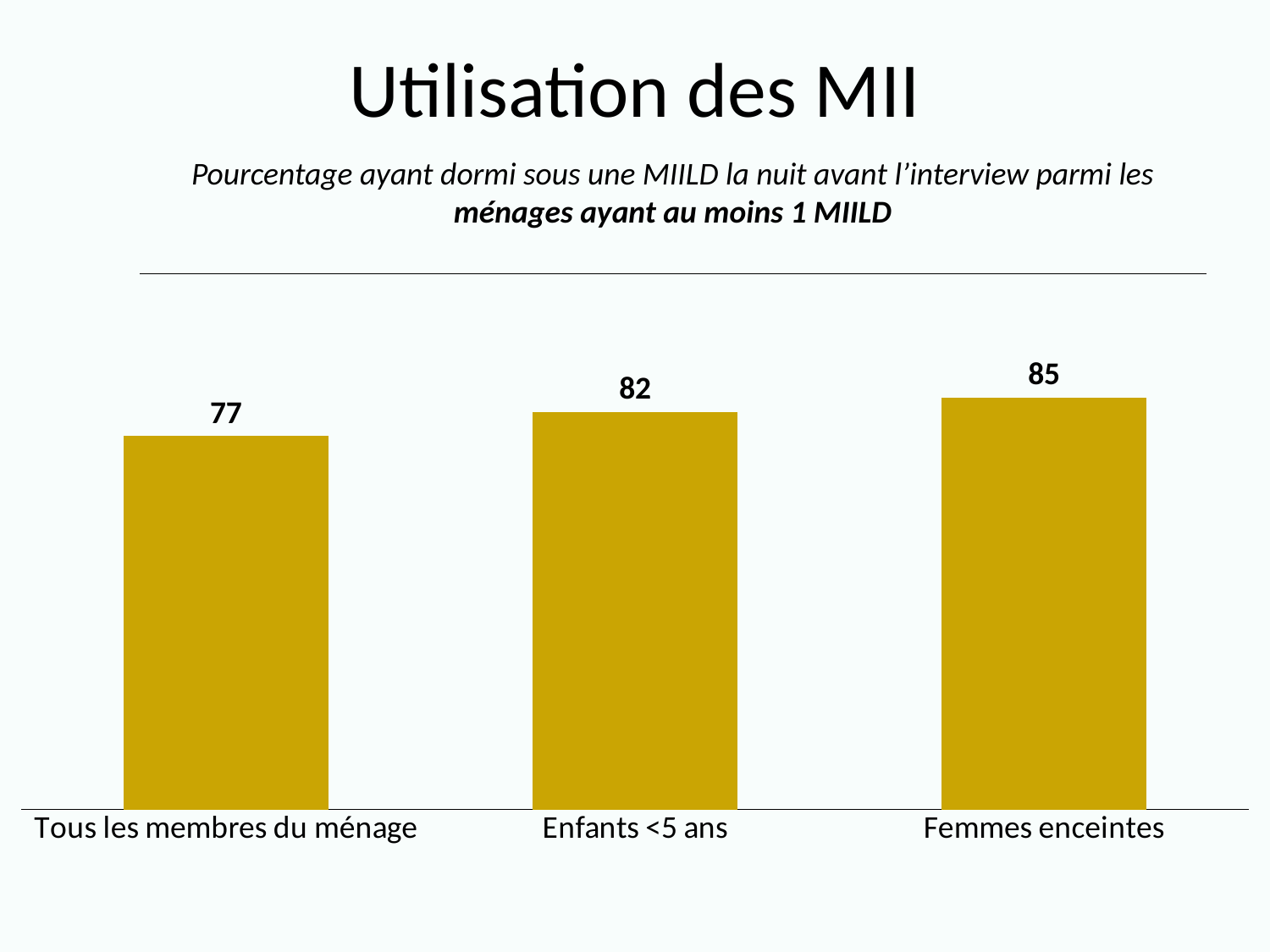
Which is larger, the value for Enfants <5 ans or the value for Femmes enceintes? Femmes enceintes What is the difference between the values for Enfants <5 ans and Tous les membres du ménage? 5 What is the difference between the values for Femmes enceintes and Tous les membres du ménage? 8 Do the values rise or fall from left to right across the categories? Rise Which category has the highest value? Femmes enceintes What is the value for Femmes enceintes? 85 What is the title of the slide? Utilisation des MII What is the value for Enfants <5 ans? 82 How many categories are shown in the chart? 3 What kind of chart is shown on the slide? Bar chart What is the value for Tous les membres du ménage? 77 Which category has the lowest value? Tous les membres du ménage